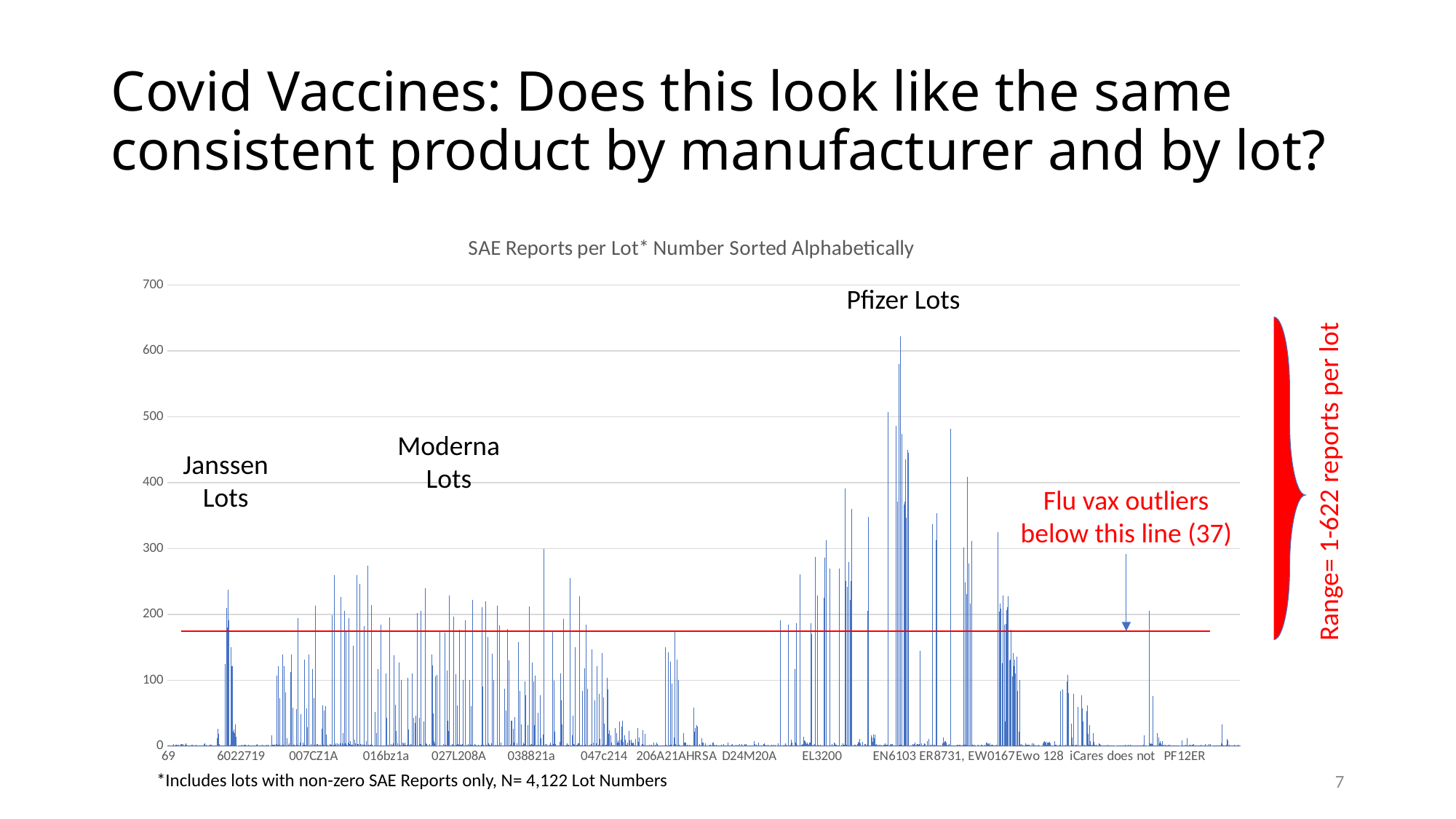
Which section has taller bars overall, Janssen Lots or Pfizer Lots? Pfizer Lots Which manufacturer's lots contain the tallest bars in the chart? Pfizer Lots How many lot numbers are included in the chart, according to the footnote? 4,122 What is the title of the chart? SAE Reports per Lot* Number Sorted Alphabetically How many flu vax outliers are noted as falling below the red line? 37 Is the tallest bar in the Pfizer Lots section greater or less than 600? greater What is the highest value shown on the y axis? 700 What is the minimum number of SAE reports per lot, as stated in the range annotation? 1 What is the maximum number of SAE reports for a single lot, as stated on the slide? 622 According to the annotation, what is the range of SAE reports per lot? 1-622 reports per lot What kind of chart is shown on the slide? bar chart Is the tallest bar in the Janssen Lots section greater or less than 300? less